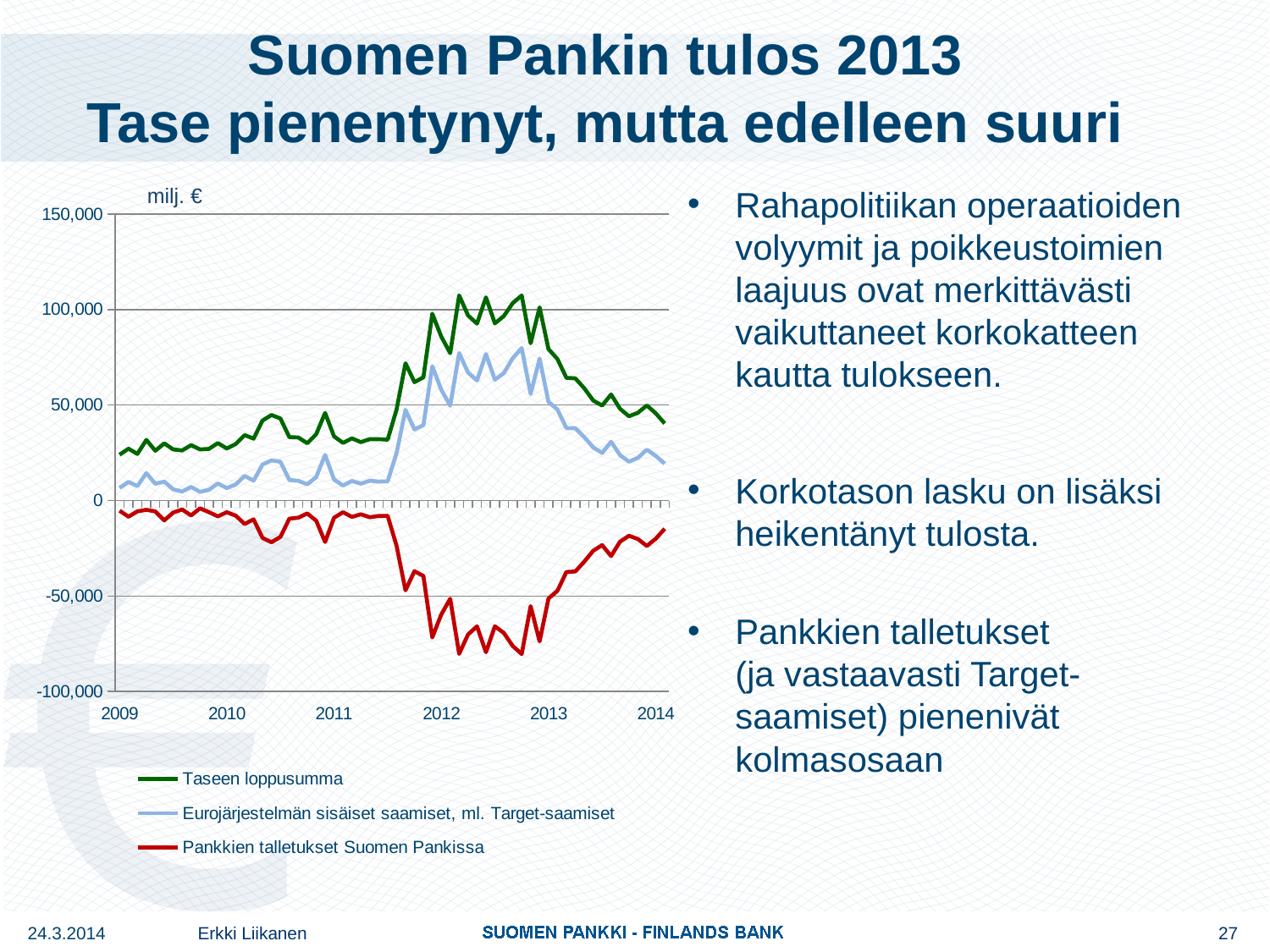
How many series does the chart legend list? 3 Which series stays below 0 for the whole period shown? Pankkien talletukset Suomen Pankissa In 2012, which series is higher: Taseen loppusumma or Eurojärjestelmän sisäiset saamiset, ml. Target-saamiset? Taseen loppusumma Is the peak value of Taseen loppusumma in 2012 greater or less than 100,000? greater Does Pankkien talletukset Suomen Pankissa rise or fall between 2013 and 2014? rise Is the lowest value of Pankkien talletukset Suomen Pankissa greater or less than -50,000? less What unit is shown above the y axis of the chart? milj. € Which series is drawn in red in the chart? Pankkien talletukset Suomen Pankissa Does Taseen loppusumma rise or fall between 2013 and 2014? fall Is the value of Taseen loppusumma at the start of 2009 greater or less than 50,000? less What kind of chart is shown on the slide? line chart